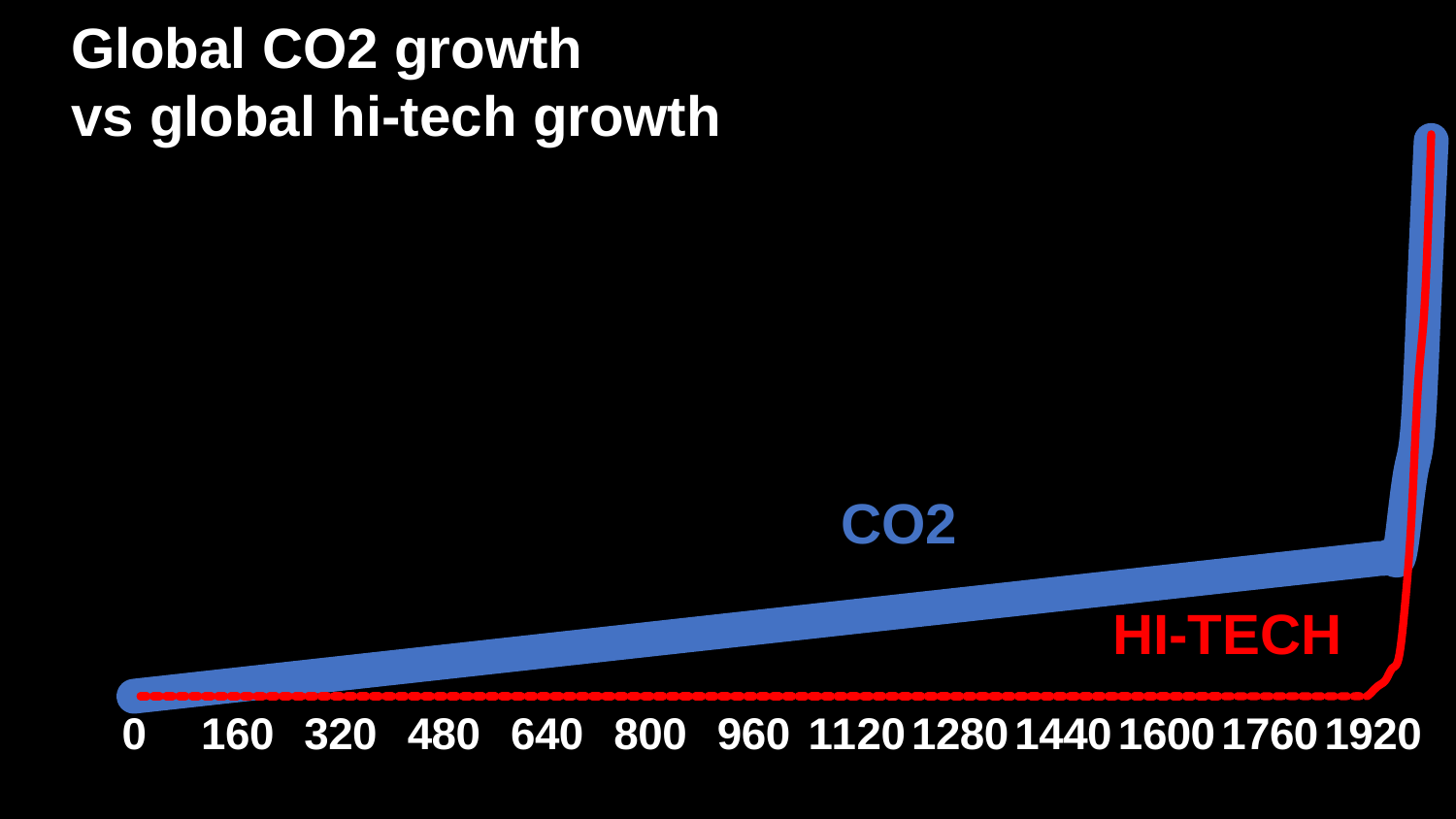
What is the title of the chart? Global CO2 growth vs global hi-tech growth Does the CO2 line rise or fall as you move from 0 to 1920 along the x axis? rise Which series stays flat for most of the x axis before rising sharply at the end? HI-TECH What is the largest value labelled on the x axis? 1920 What kind of chart is shown on the slide? line chart How many series are plotted on the chart? 2 At x = 960, which series is higher, CO2 or HI-TECH? CO2 What is the spacing between consecutive x-axis tick labels? 160 How many tick labels are shown on the x axis? 13 What is the smallest value labelled on the x axis? 0 At x = 1600, which series is lower, CO2 or HI-TECH? HI-TECH What colour is the CO2 line? blue